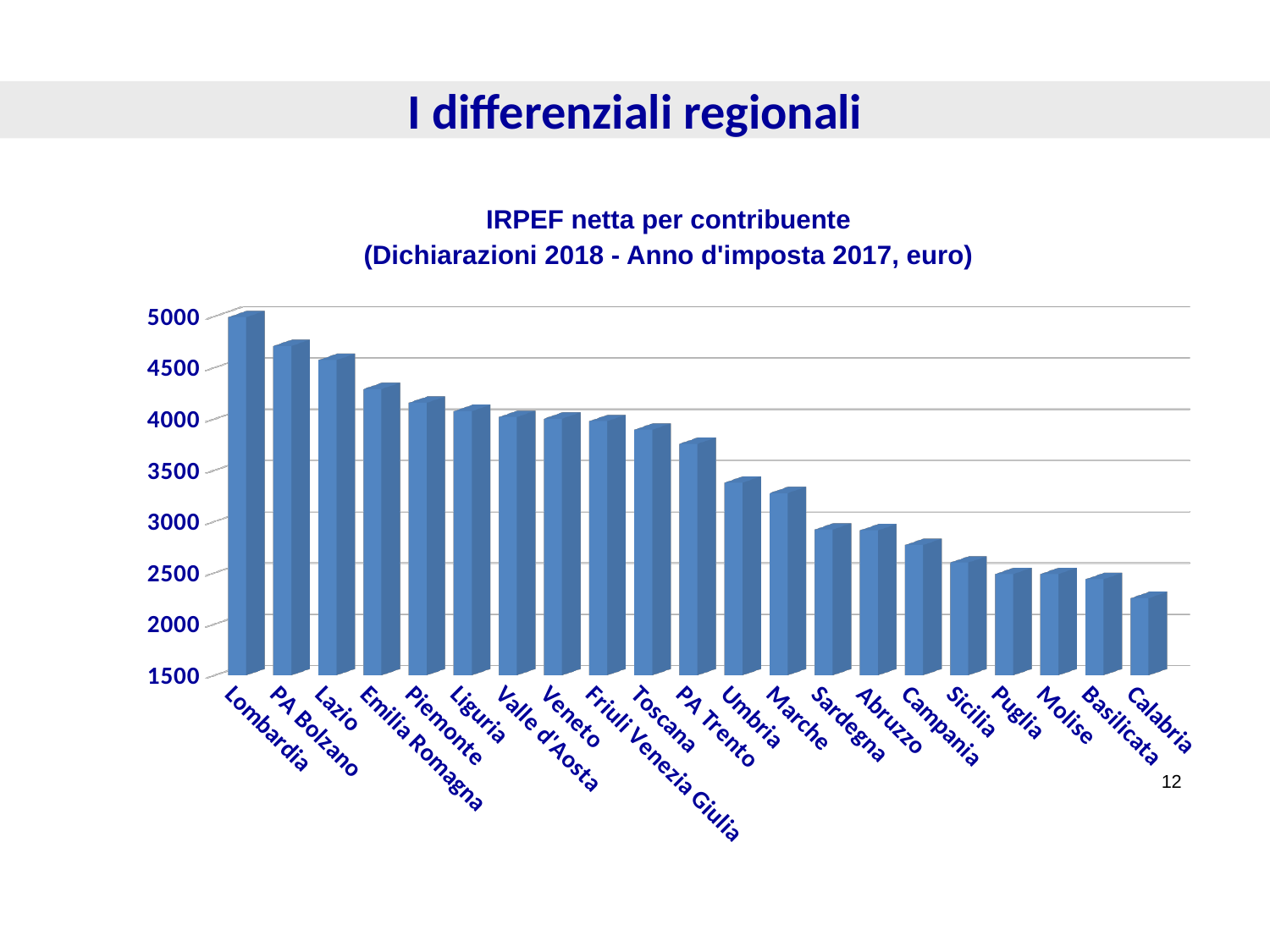
Which region has the highest IRPEF netta per contribuente? Lombardia How many regions (categories) are plotted in the chart? 21 Is the value for PA Bolzano greater or less than 4500? greater Do the values rise or fall moving from left to right along the x axis? fall Which region has the lowest IRPEF netta per contribuente? Calabria What is the title of the chart? IRPEF netta per contribuente (Dichiarazioni 2018 - Anno d'imposta 2017, euro) Is the value for Umbria greater or less than 3500? less What kind of chart is shown on the slide? bar chart Is the value for Campania greater or less than 3000? less Which has a larger value, Lazio or Marche? Lazio